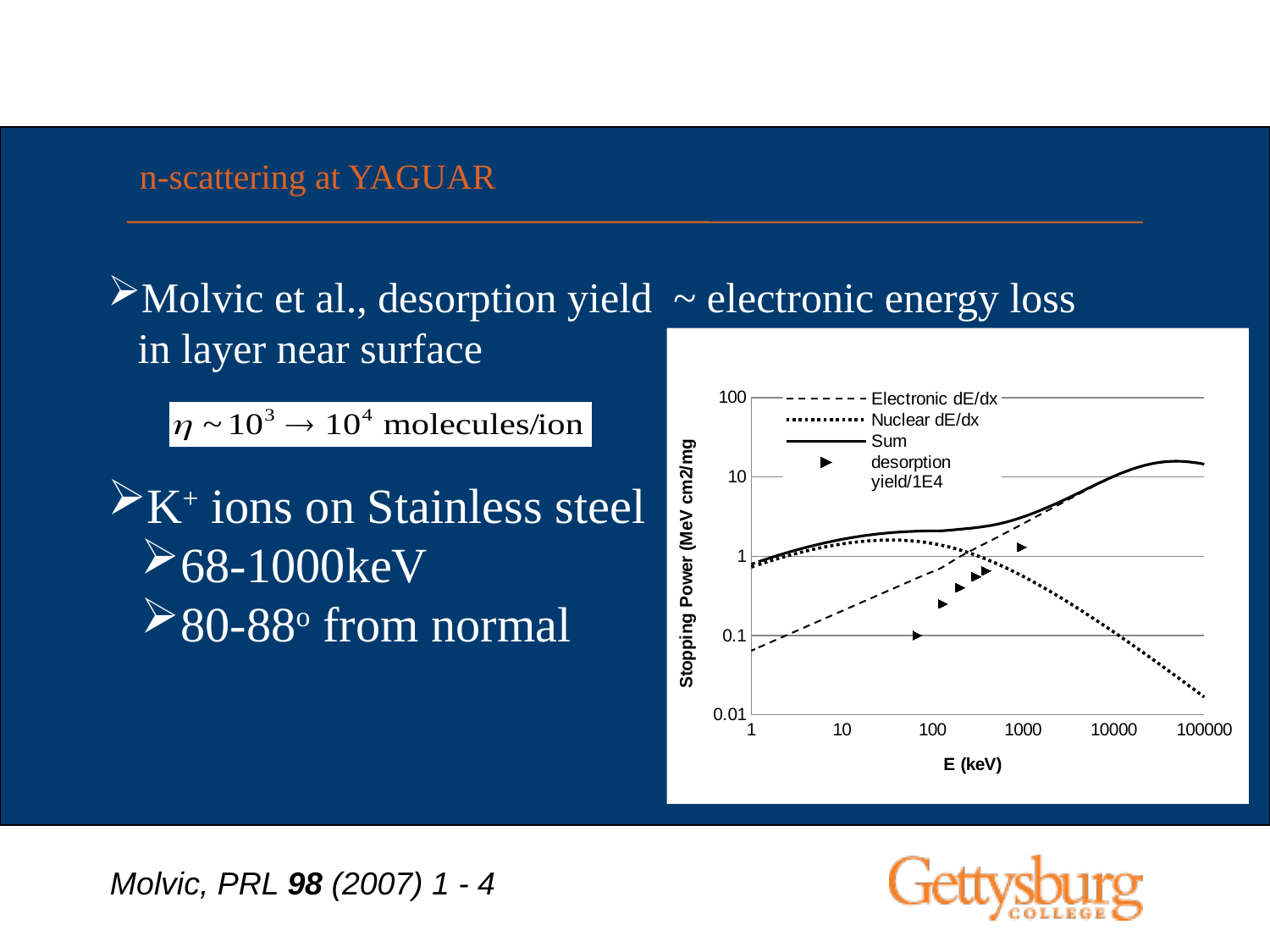
At E = 1 keV, which is larger, Electronic dE/dx or Nuclear dE/dx? Nuclear dE/dx Is the Electronic dE/dx value at E = 1 keV greater or less than 0.1? less Is the Nuclear dE/dx value at E = 10 keV greater or less than 1? greater Is the Sum value at E = 100000 keV greater or less than 10? greater Does the Nuclear dE/dx curve rise or fall as E increases from 1000 keV to 100000 keV? fall Does the Electronic dE/dx curve rise or fall as E increases from 1 keV to 10000 keV? rise How many series does the chart legend list? 4 At E = 100000 keV, which is larger, Electronic dE/dx or Nuclear dE/dx? Electronic dE/dx Which series in the chart is plotted with triangular markers rather than a line? desorption yield/1E4 What is the label of the x axis of the chart? E (keV) What kind of chart is shown on the slide? line chart